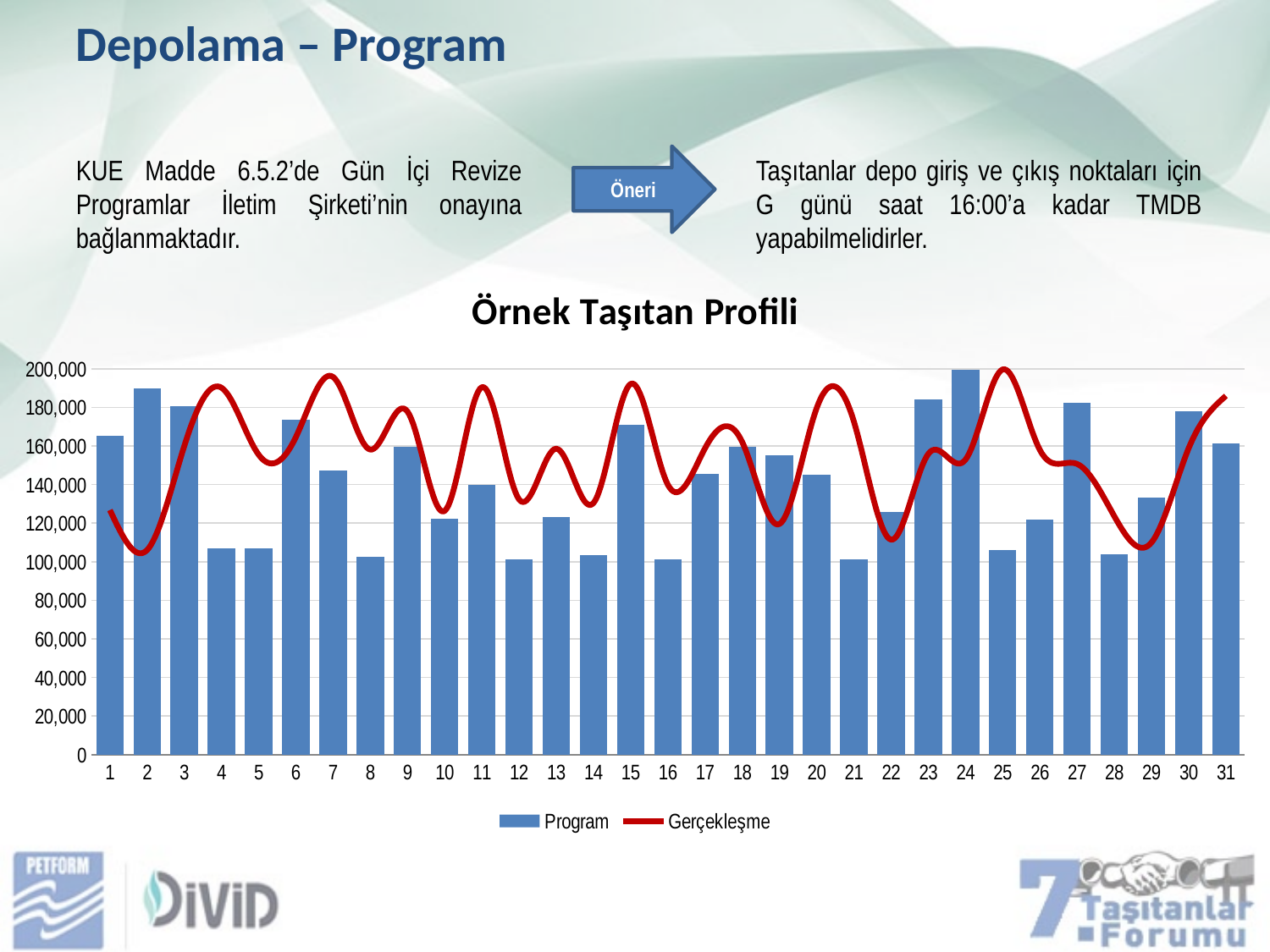
How many series does the chart's legend list? 2 Which has the larger Program value, category 24 or category 1? 24 How many categories are shown along the x axis of the chart? 31 Is the Program value for category 4 greater or less than 120,000? less Is the Program value for category 15 greater or less than 160,000? greater Is the Program value for category 28 greater or less than 120,000? less Which category has the highest Program bar? 24 Which has the larger Program value, category 2 or category 4? 2 What kind of chart is shown on the slide? A bar chart combined with a line What are the two series named in the chart's legend? Program and Gerçekleşme What is the title of the chart on the slide? Örnek Taşıtan Profili